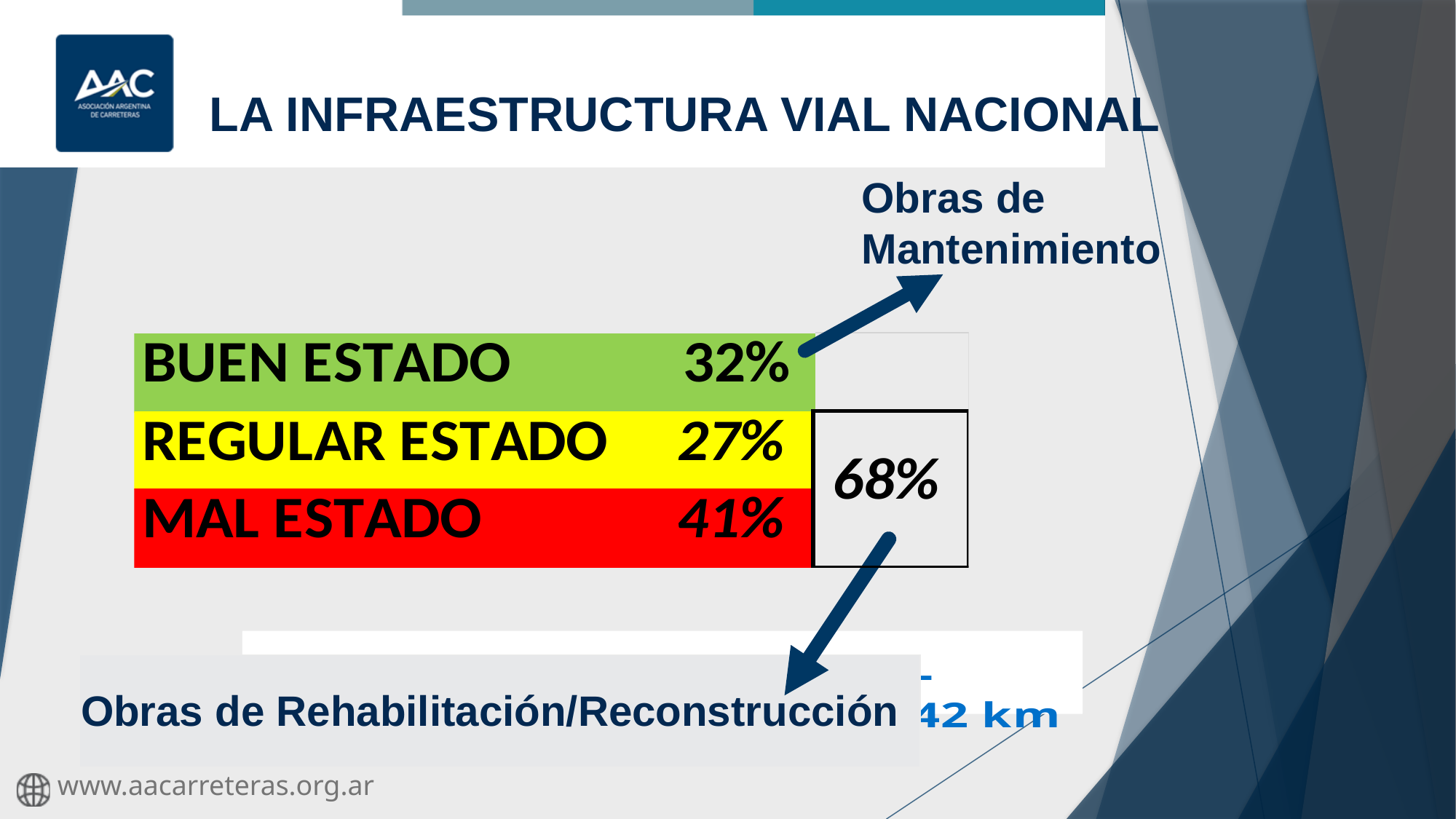
What is the difference between the MAL ESTADO and BUEN ESTADO percentages? 9% What percentage is shown for MAL ESTADO? 41% What percentage is shown for REGULAR ESTADO? 27% Which condition category has the highest percentage? MAL ESTADO Which is larger, the percentage for BUEN ESTADO or for REGULAR ESTADO? BUEN ESTADO What colour is the row for MAL ESTADO? Red What combined percentage is shown for REGULAR ESTADO and MAL ESTADO together? 68% Which condition category has the lowest percentage? REGULAR ESTADO What percentage of the national road network is in BUEN ESTADO? 32% How many condition categories are listed in the table? 3 Which type of works does the arrow from the BUEN ESTADO row point to? Obras de Mantenimiento